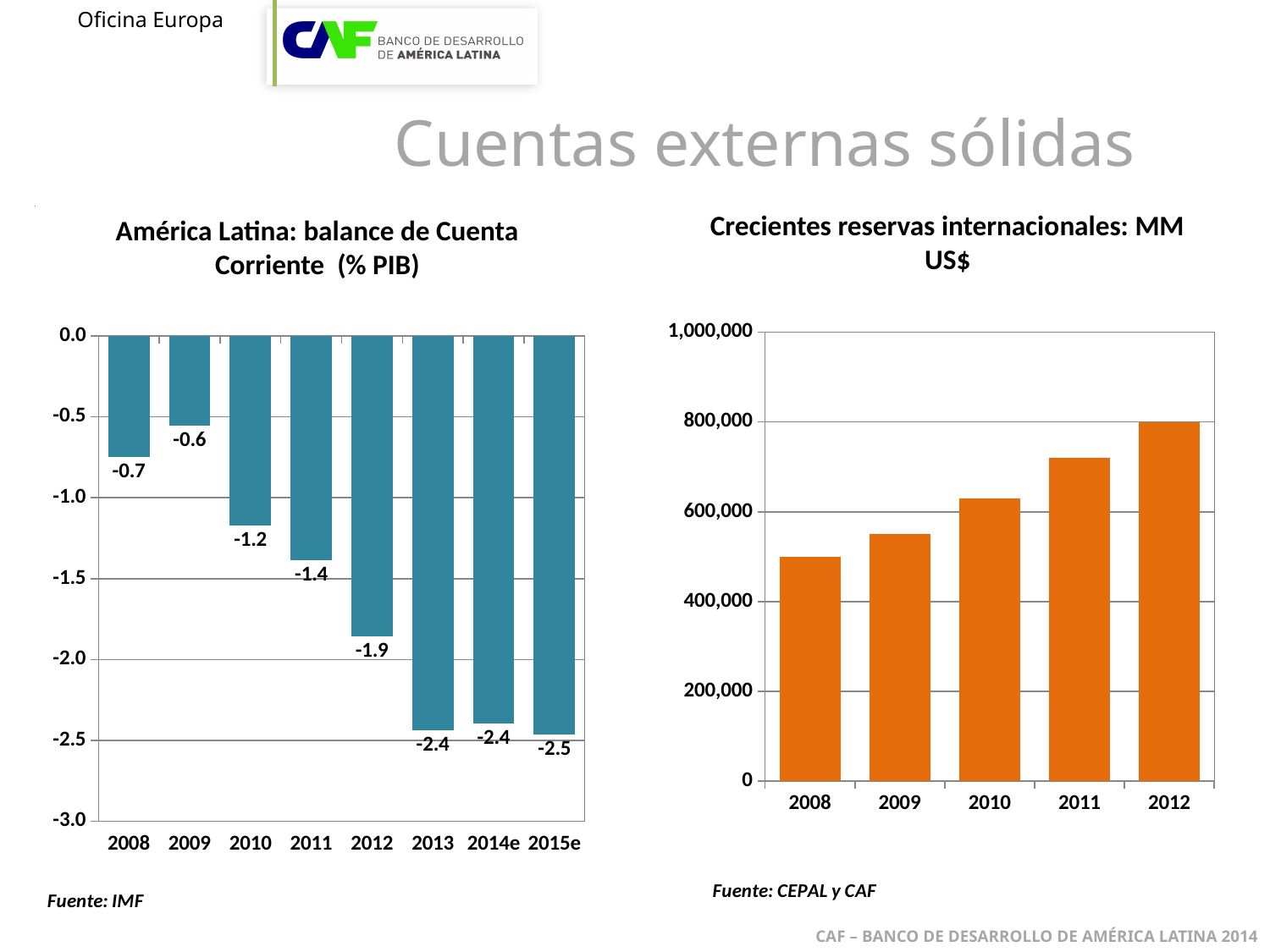
In the chart 'Crecientes reservas internacionales: MM US$', which year has the highest value? 2012 In the chart 'Crecientes reservas internacionales: MM US$', is the value for 2008 greater or less than 400,000? greater In the chart 'Crecientes reservas internacionales: MM US$', is the value for 2009 greater or less than 600,000? less In the chart 'América Latina: balance de Cuenta Corriente (% PIB)', how many years are shown on the x axis? 8 In the chart 'Crecientes reservas internacionales: MM US$', is the value for 2011 greater or less than 600,000? greater In the chart 'América Latina: balance de Cuenta Corriente (% PIB)', which year has the lowest value? 2015e What kind of chart is 'Crecientes reservas internacionales: MM US$'? bar chart In the chart 'América Latina: balance de Cuenta Corriente (% PIB)', what is the value for 2012? -1.9 In the chart 'América Latina: balance de Cuenta Corriente (% PIB)', which year has the highest value? 2009 In the chart 'América Latina: balance de Cuenta Corriente (% PIB)', do the values generally rise or fall from 2009 to 2015e? fall In the chart 'América Latina: balance de Cuenta Corriente (% PIB)', what is the difference between the values for 2008 and 2012? 1.2 In the chart 'América Latina: balance de Cuenta Corriente (% PIB)', what is the value for 2010? -1.2